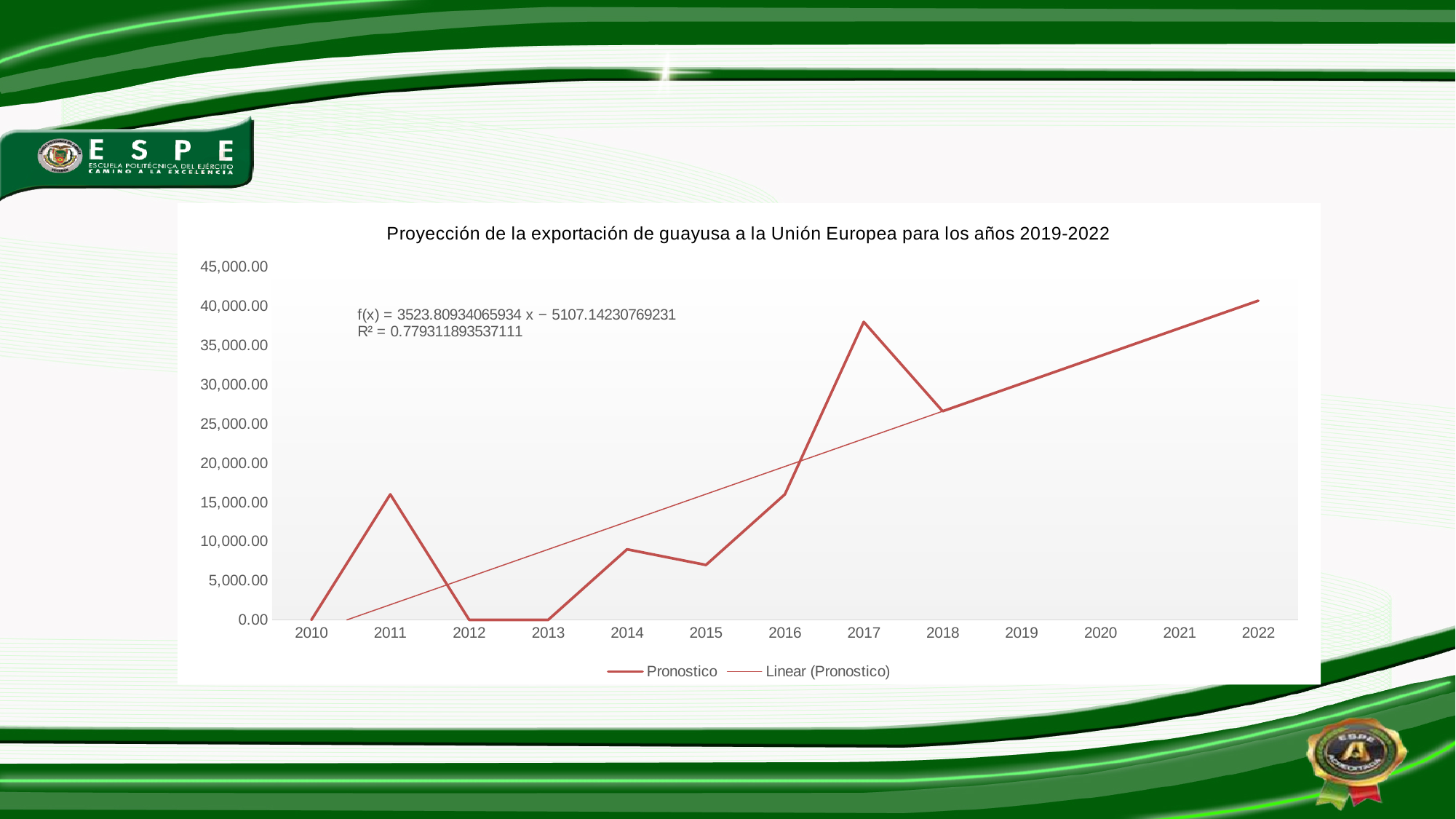
What R² value is printed on the chart? 0.779311893537111 What kind of chart is shown on the slide? line chart How many years are shown on the x axis? 13 Among the years 2010 to 2018, which year has the highest Pronostico value? 2017 What is the Pronostico value for 2013? 0.00 Is the Pronostico value for 2015 greater or less than 10,000.00? less How many series does the legend list? 2 Is the Pronostico value for 2018 greater or less than 25,000.00? greater What is the Pronostico value for 2010? 0.00 Which year has the larger Pronostico value, 2017 or 2018? 2017 Do the Pronostico values rise or fall from 2018 to 2022? rise Is the Pronostico value for 2017 greater or less than 35,000.00? greater